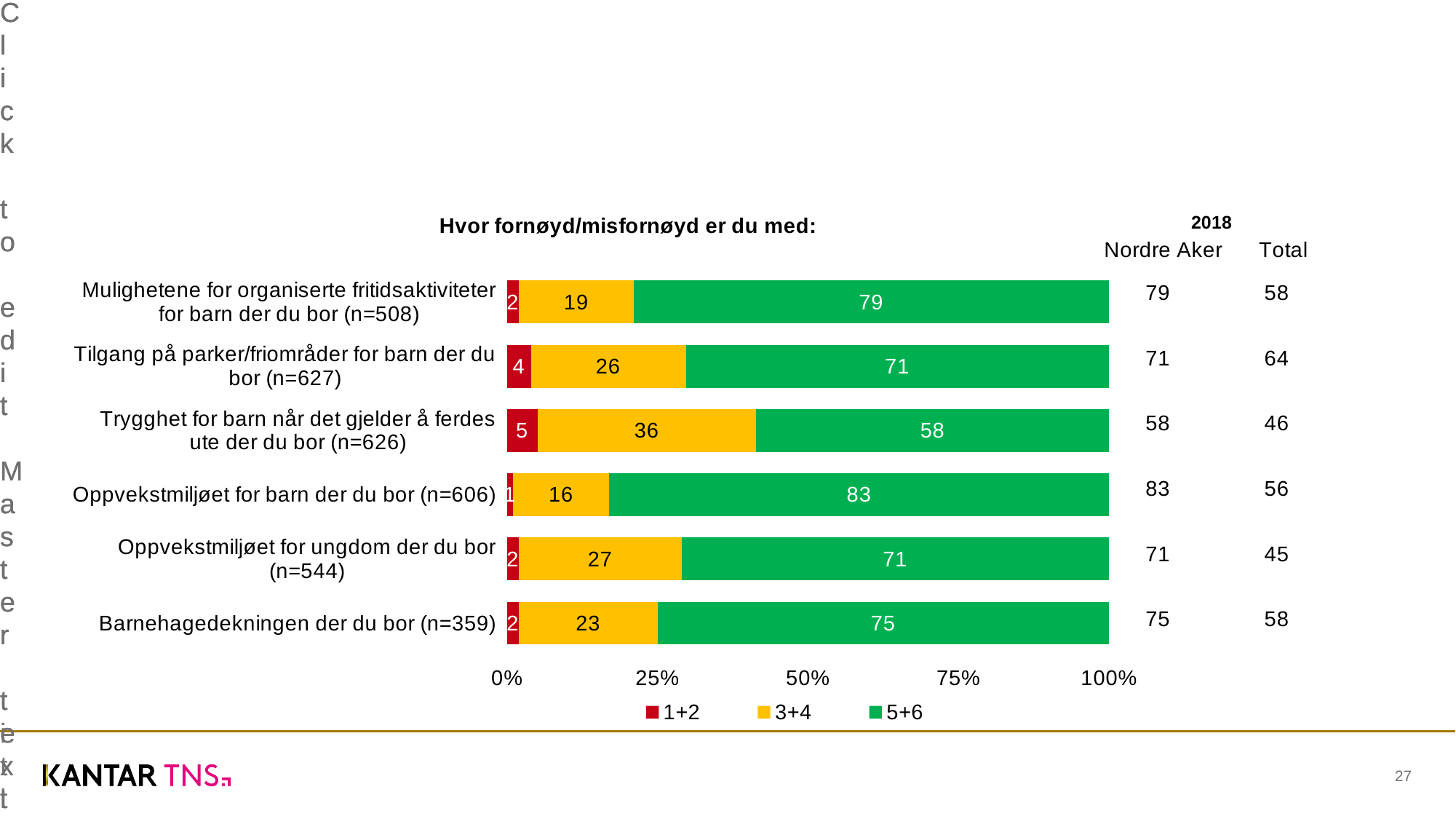
Which category has the highest 5+6 value? Oppvekstmiljøet for barn der du bor (n=606) What is the 5+6 value for "Oppvekstmiljøet for barn der du bor (n=606)"? 83 Which has a larger 3+4 value: "Oppvekstmiljøet for ungdom der du bor (n=544)" or "Barnehagedekningen der du bor (n=359)"? Oppvekstmiljøet for ungdom der du bor (n=544) Which category has the lowest 5+6 value? Trygghet for barn når det gjelder å ferdes ute der du bor (n=626) How many series does the legend list? 3 What is the difference between the 5+6 values for "Mulighetene for organiserte fritidsaktiviteter for barn der du bor (n=508)" and "Barnehagedekningen der du bor (n=359)"? 4 What is the title of the chart? Hvor fornøyd/misfornøyd er du med: What is the 1+2 value for "Tilgang på parker/friområder for barn der du bor (n=627)"? 4 What is the 3+4 value for "Trygghet for barn når det gjelder å ferdes ute der du bor (n=626)"? 36 What kind of chart is shown on the slide? Stacked bar chart How many categories are shown in the chart? 6 What is the total of the stacked bar for "Tilgang på parker/friområder for barn der du bor (n=627)"? 101